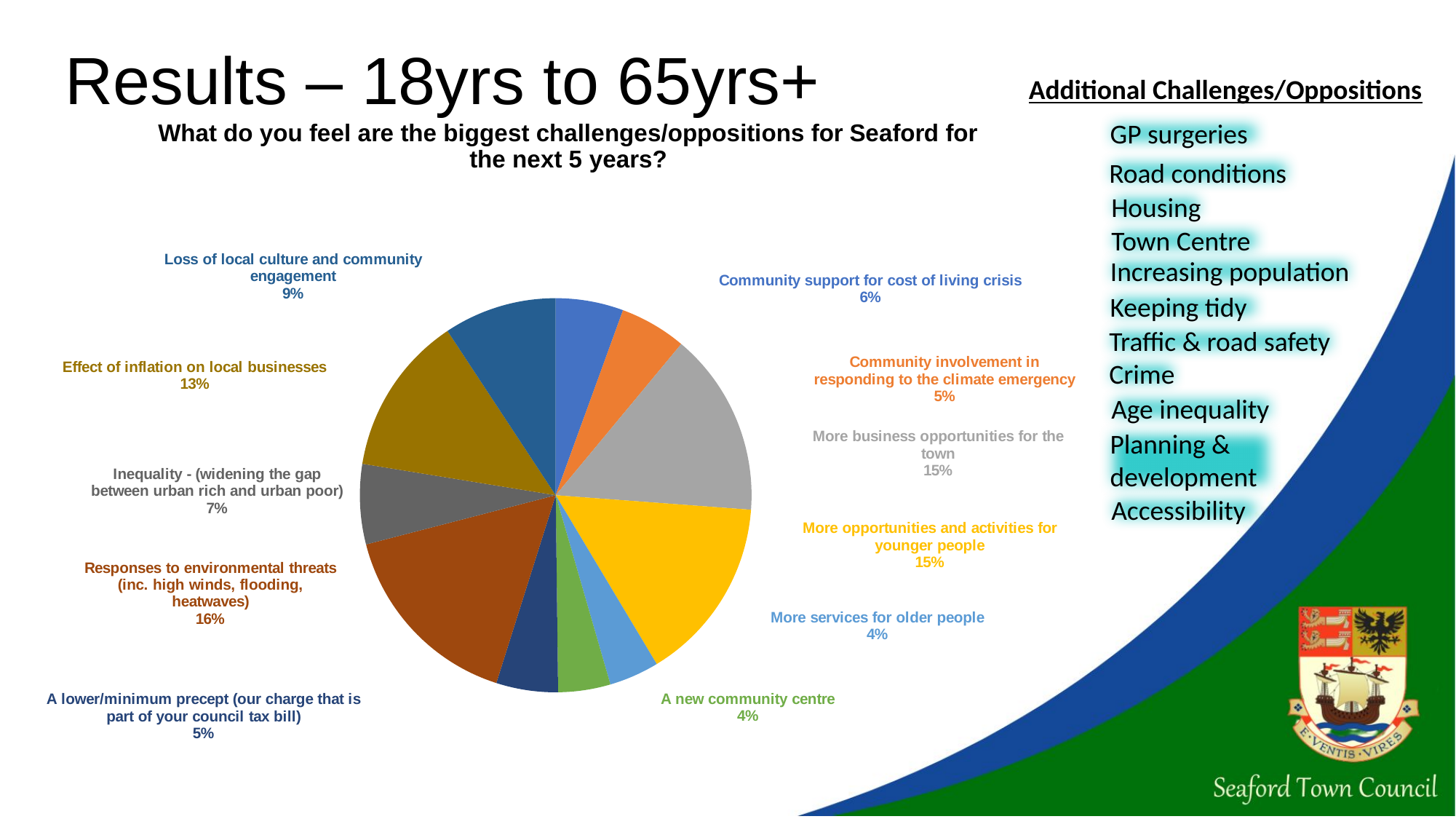
What percentage is shown for 'More business opportunities for the town'? 15% Which is larger: 'Effect of inflation on local businesses' or 'Loss of local culture and community engagement'? Effect of inflation on local businesses What type of chart is shown on the slide? Pie chart What percentage is shown for 'Community support for cost of living crisis'? 6% What percentage is shown for 'Loss of local culture and community engagement'? 9% What percentage is shown for 'Effect of inflation on local businesses'? 13% What question is the pie chart reporting results for? What do you feel are the biggest challenges/oppositions for Seaford for the next 5 years? Which category has the largest share of the pie? Responses to environmental threats (inc. high winds, flooding, heatwaves) How many categories are shown in the pie chart? 11 What is the difference in percentage points between 'Responses to environmental threats' and 'Effect of inflation on local businesses'? 3 percentage points What percentage is shown for 'More services for older people'? 4% What percentage of responses is for 'Responses to environmental threats (inc. high winds, flooding, heatwaves)'? 16%